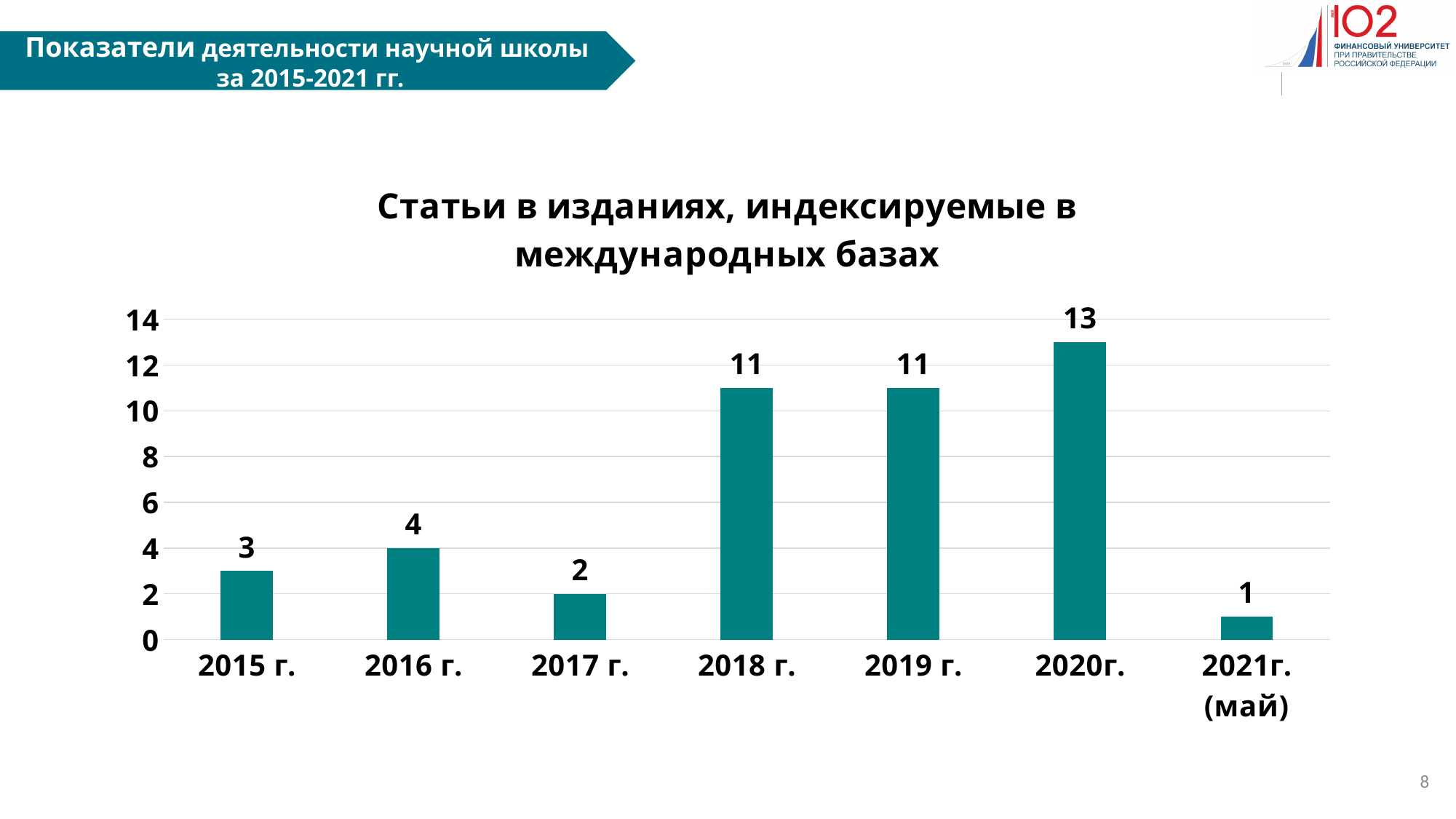
Which year has the highest value? 2020г. What is the value for 2018 г.? 11 How many categories are shown on the x axis? 7 What is the difference between the values for 2020г. and 2017 г.? 11 Is the value for 2019 г. greater or less than 10? greater What is the title of the chart? Статьи в изданиях, индексируемые в международных базах Which category has the lowest value? 2021г. (май) Do the values rise or fall from 2017 г. to 2020г.? rise Which is larger, the value for 2016 г. or the value for 2017 г.? 2016 г. What is the value for 2015 г.? 3 What is the value for 2021г. (май)? 1 What kind of chart is this? bar chart